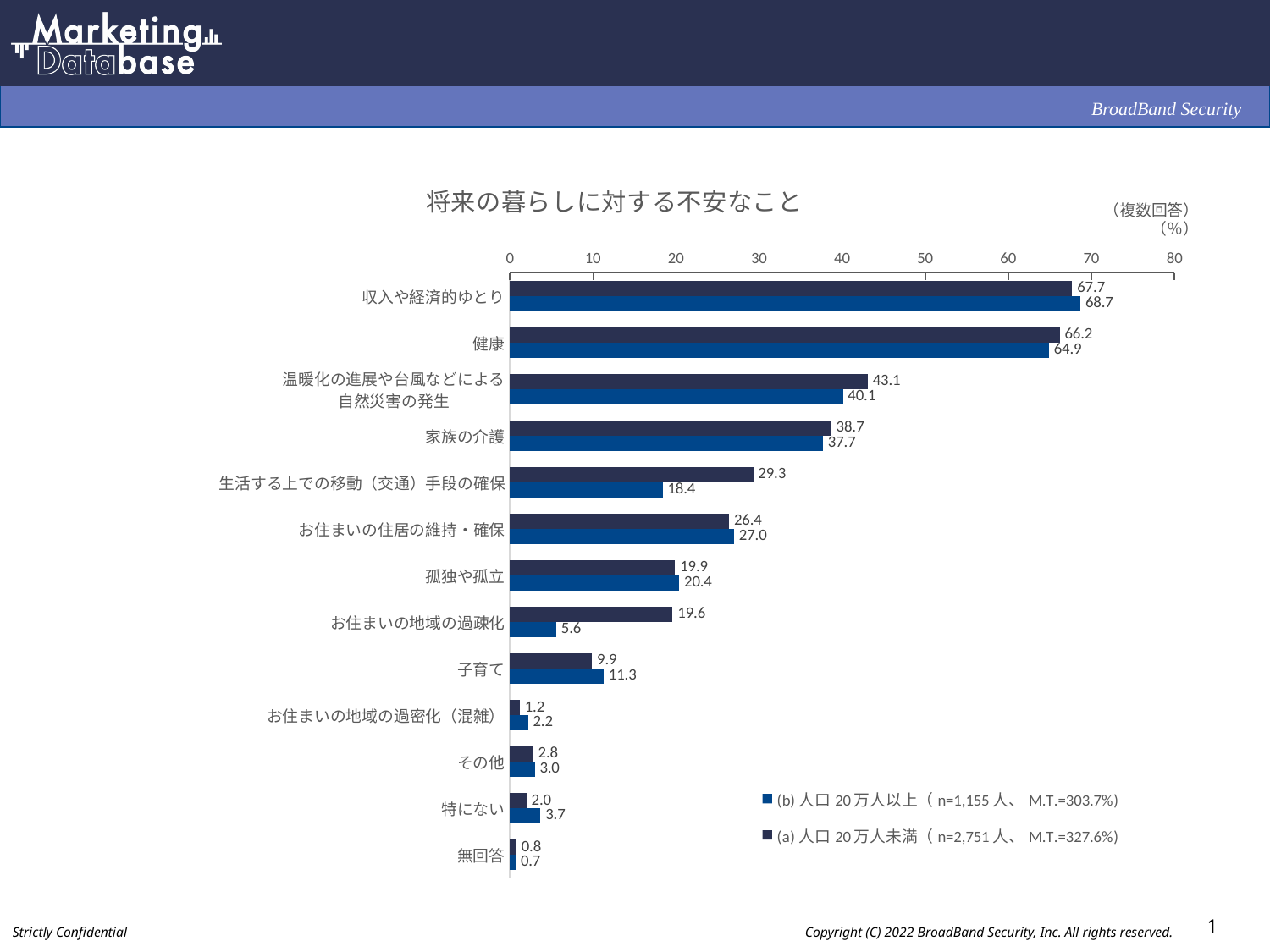
What is the title of the chart? 将来の暮らしに対する不安なこと What is the value for 生活する上での移動（交通）手段の確保 in the (b) 人口20万人以上 series? 18.4 How many categories are plotted on the chart? 13 What is the difference between the (a) 人口20万人未満 and (b) 人口20万人以上 values for お住まいの地域の過疎化? 14.0 What type of chart is shown on the slide? bar chart What is the value for 特にない in the (b) 人口20万人以上 series? 3.7 For 子育て, which series has the larger value, (a) 人口20万人未満 or (b) 人口20万人以上? (b) 人口20万人以上 Which category has the highest value in the (b) 人口20万人以上 series? 収入や経済的ゆとり What is the value for 健康 in the (a) 人口20万人未満 series? 66.2 How many series does the legend list? 2 Which category has the lowest value in the (b) 人口20万人以上 series? 無回答 Is the value for 温暖化の進展や台風などによる自然災害の発生 in the (a) 人口20万人未満 series greater or less than 40? greater